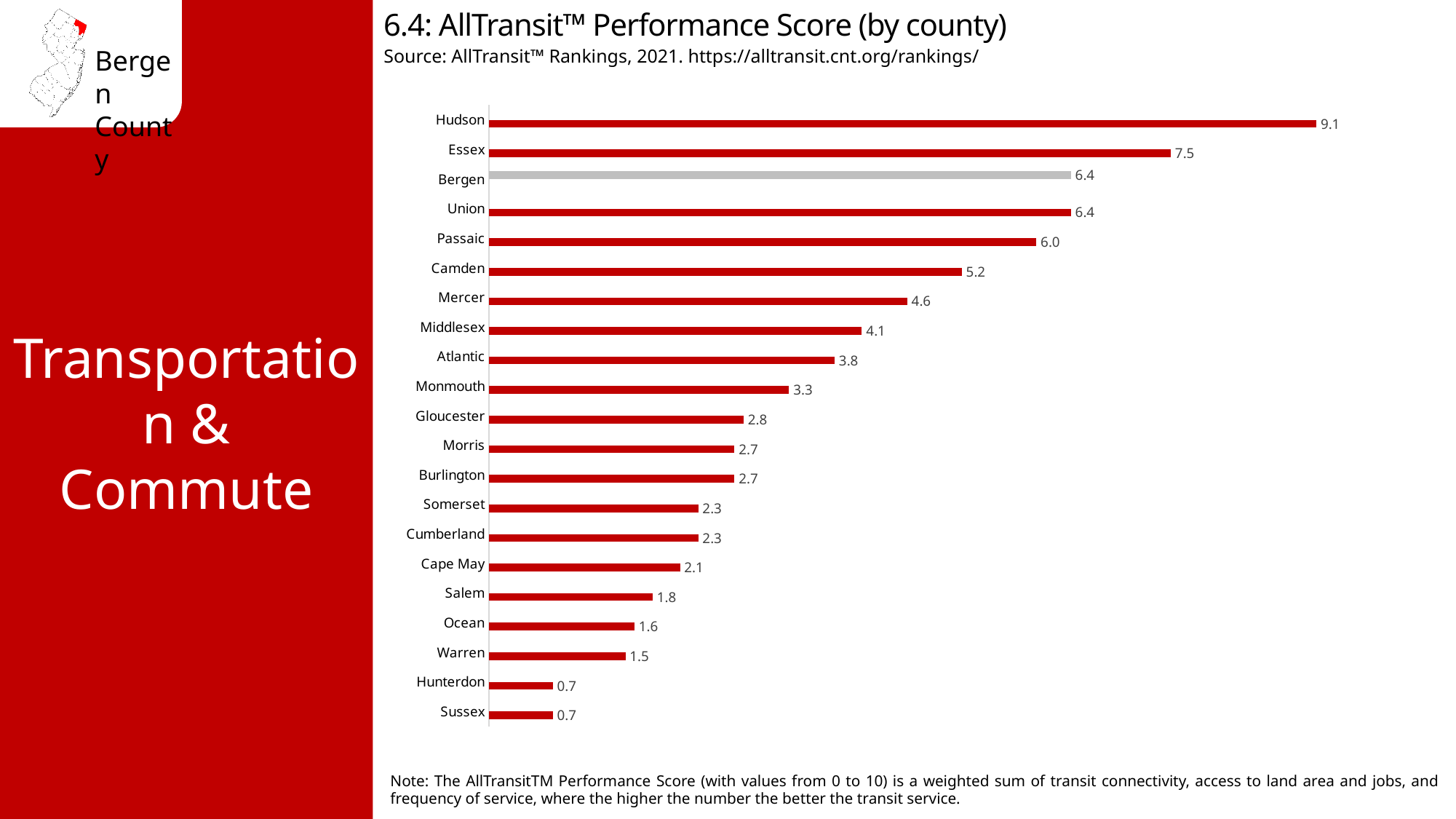
How many counties are shown in the chart? 21 Which two counties share the lowest AllTransit Performance Score of 0.7? Hunterdon and Sussex Which county has the highest AllTransit Performance Score? Hudson What is the source cited for the AllTransit Performance Score chart? AllTransit™ Rankings, 2021 What is the difference between the AllTransit Performance Scores of Bergen and Salem? 4.6 Which county's bar is shown in grey rather than red? Bergen What is the AllTransit Performance Score for Bergen County? 6.4 What is the difference between the AllTransit Performance Scores of Hudson and Essex? 1.6 What is the AllTransit Performance Score for Passaic County? 6.0 What is the AllTransit Performance Score for Monmouth County? 3.3 What kind of chart is used to show the AllTransit Performance Score by county? Bar chart Which county has a higher AllTransit Performance Score, Camden or Mercer? Camden